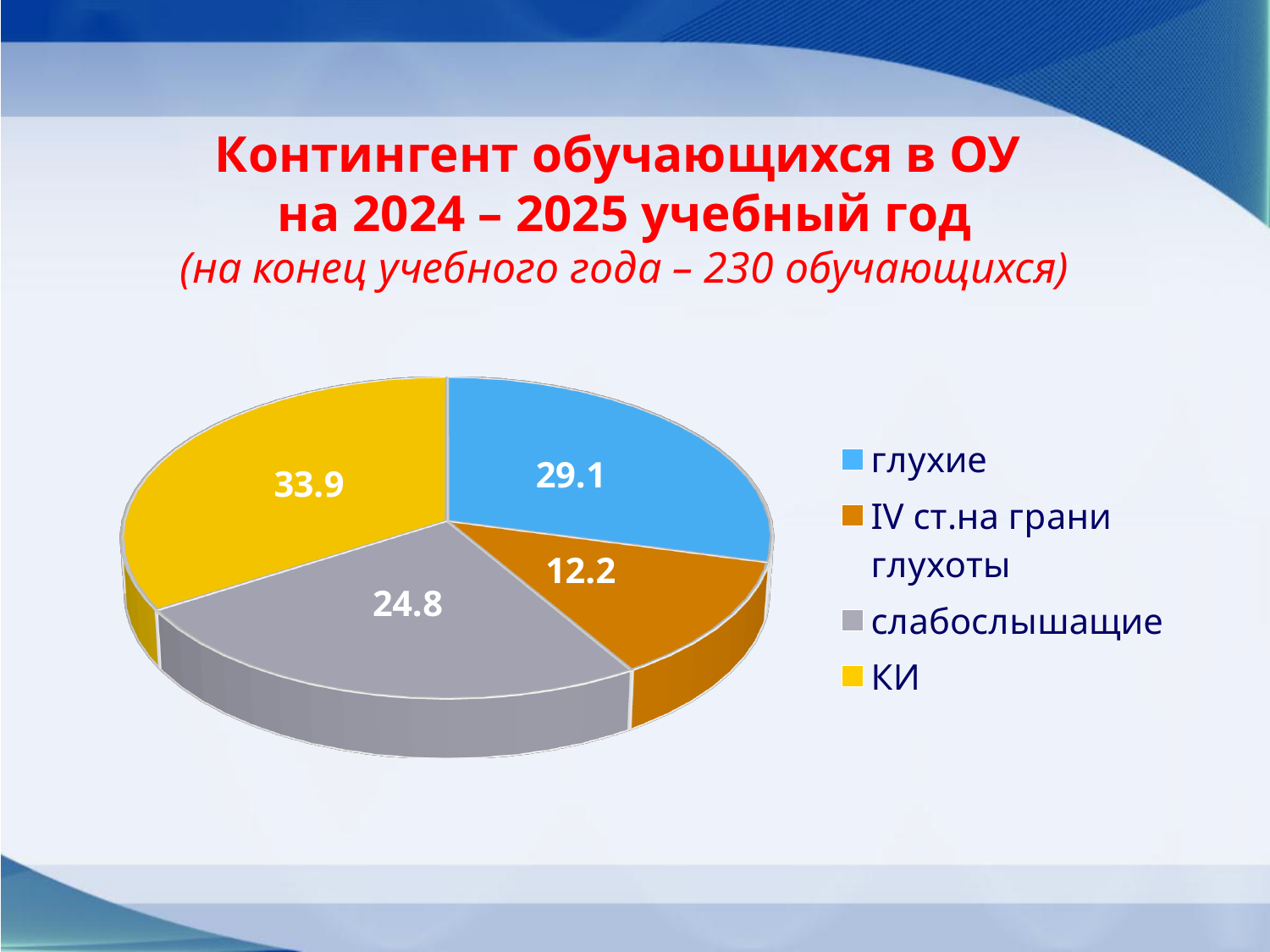
What is the difference between the values for КИ and глухие? 4.8 What value is shown for the глухие slice? 29.1 How many categories does the pie chart show? 4 What is the difference between the values for слабослышащие and IV ст.на грани глухоты? 12.6 What value is shown for the IV ст.на грани глухоты slice? 12.2 Which colour represents слабослышащие in the legend? Grey What value is shown for the КИ slice? 33.9 Which is larger, the value for глухие or the value for слабослышащие? глухие What value is shown for the слабослышащие slice? 24.8 What type of chart is shown on the slide? Pie chart Which category has the largest slice of the pie? КИ Which category has the smallest slice of the pie? IV ст.на грани глухоты